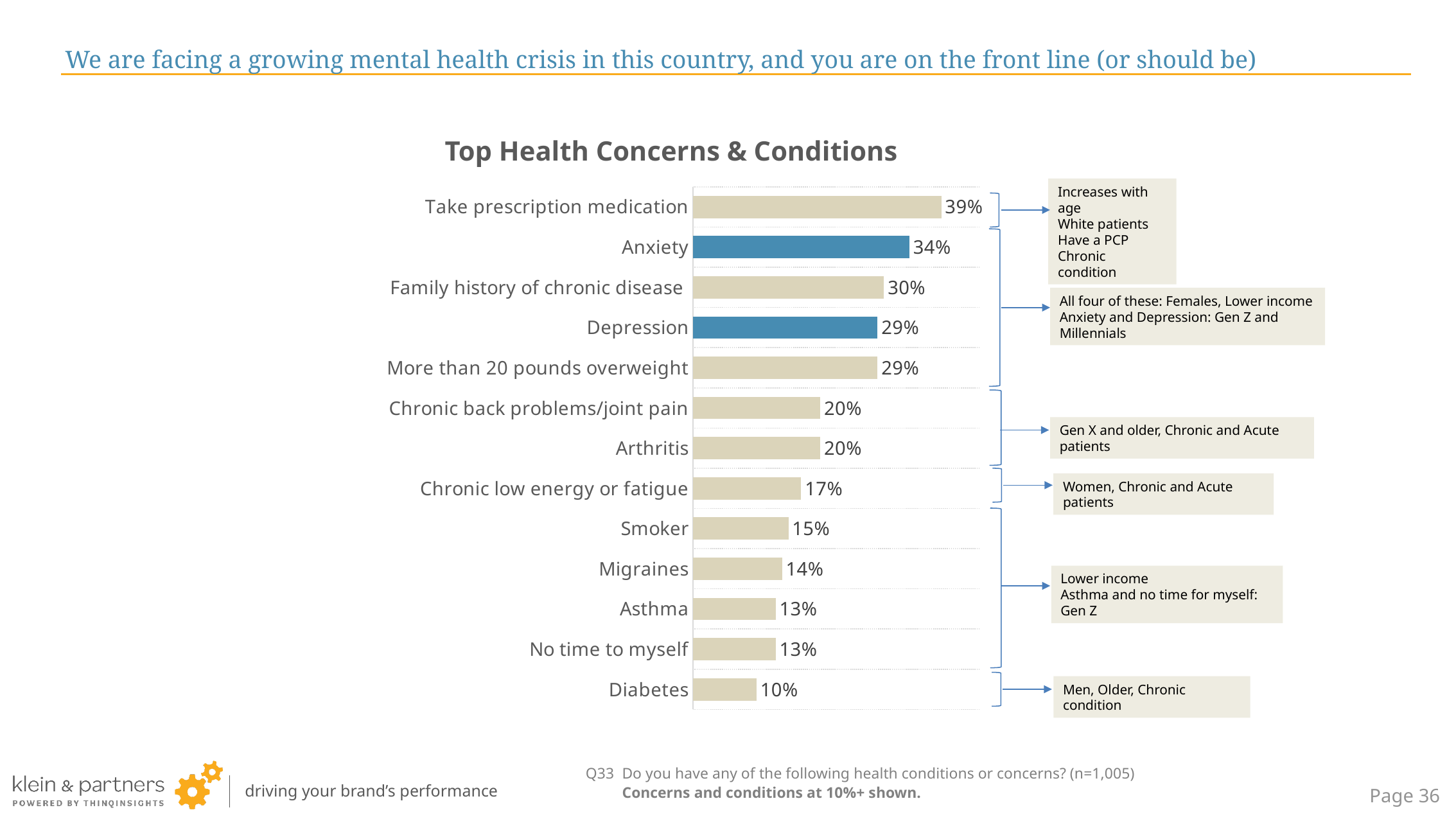
What is the value for Anxiety? 34% What is the difference between the values for Anxiety and Depression? 5% What kind of chart is shown on the slide? Bar chart Which category has the lowest value? Diabetes How many categories are shown in the chart? 13 What is the value for Take prescription medication? 39% Which two categories are shown with blue bars? Anxiety and Depression What is the value for Diabetes? 10% Which category has the highest value? Take prescription medication Which is larger, the value for Family history of chronic disease or the value for Smoker? Family history of chronic disease What is the value for Chronic low energy or fatigue? 17% What is the title of the chart? Top Health Concerns & Conditions